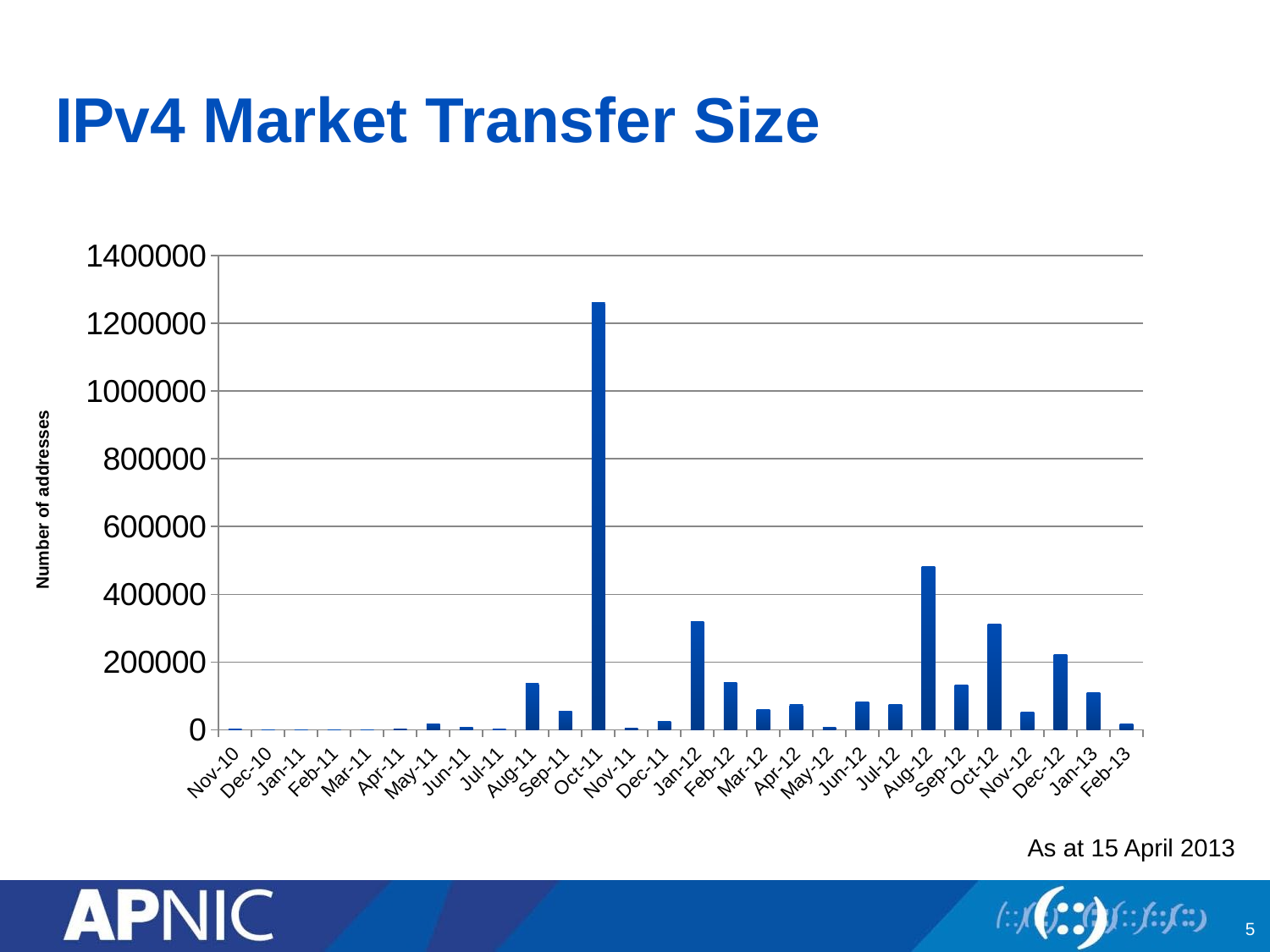
What is the title of the chart? IPv4 Market Transfer Size How many months are shown along the x axis of the chart? 28 Is the value for Jan-12 greater or less than 200000? greater Is the value for Aug-12 greater or less than 400000? greater What is the label on the vertical axis of the chart? Number of addresses Which month has the larger value, Oct-12 or Feb-12? Oct-12 Which month has the larger value, Aug-12 or Jan-12? Aug-12 What kind of chart is shown on the slide? Bar chart Is the value for Jan-13 greater or less than 200000? less Which month has the highest number of addresses transferred? Oct-11